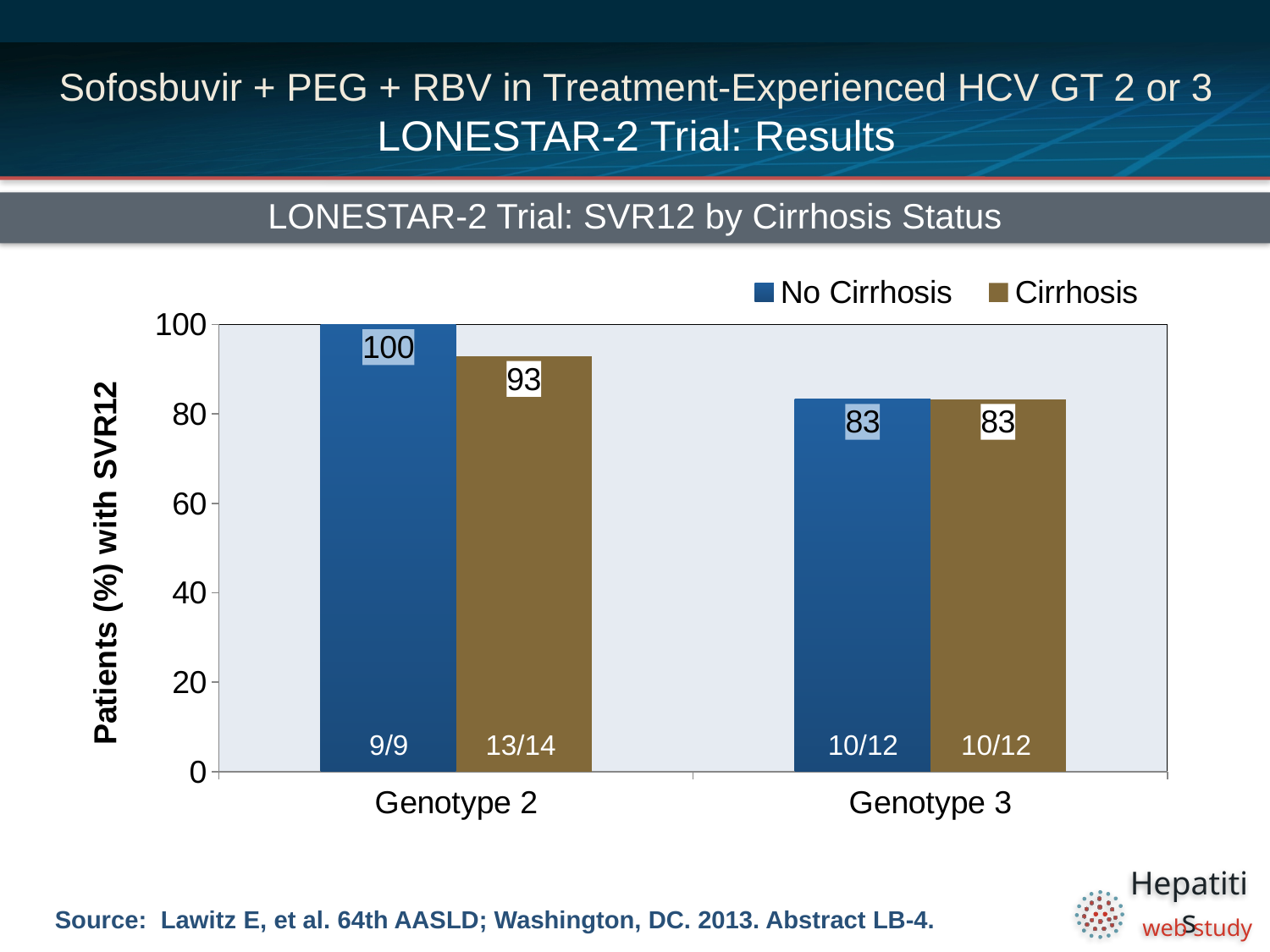
What is the SVR12 rate for patients with cirrhosis in Genotype 2? 93 What is the difference in SVR12 rate for No Cirrhosis patients between Genotype 2 and Genotype 3? 17 Which bar has the highest SVR12 rate? No Cirrhosis, Genotype 2 What is the SVR12 rate for patients with no cirrhosis in Genotype 2? 100 How many genotype groups are shown on the x axis? 2 What fraction of patients is shown for the No Cirrhosis bar in Genotype 3? 10/12 What is the difference in SVR12 rate between No Cirrhosis and Cirrhosis patients in Genotype 2? 7 What fraction of patients is shown for the Cirrhosis bar in Genotype 2? 13/14 What kind of chart is shown on the slide? Bar chart What is the SVR12 rate for patients with cirrhosis in Genotype 3? 83 How many series does the legend list? 2 Which is larger, the SVR12 rate for Cirrhosis patients in Genotype 2 or in Genotype 3? Genotype 2